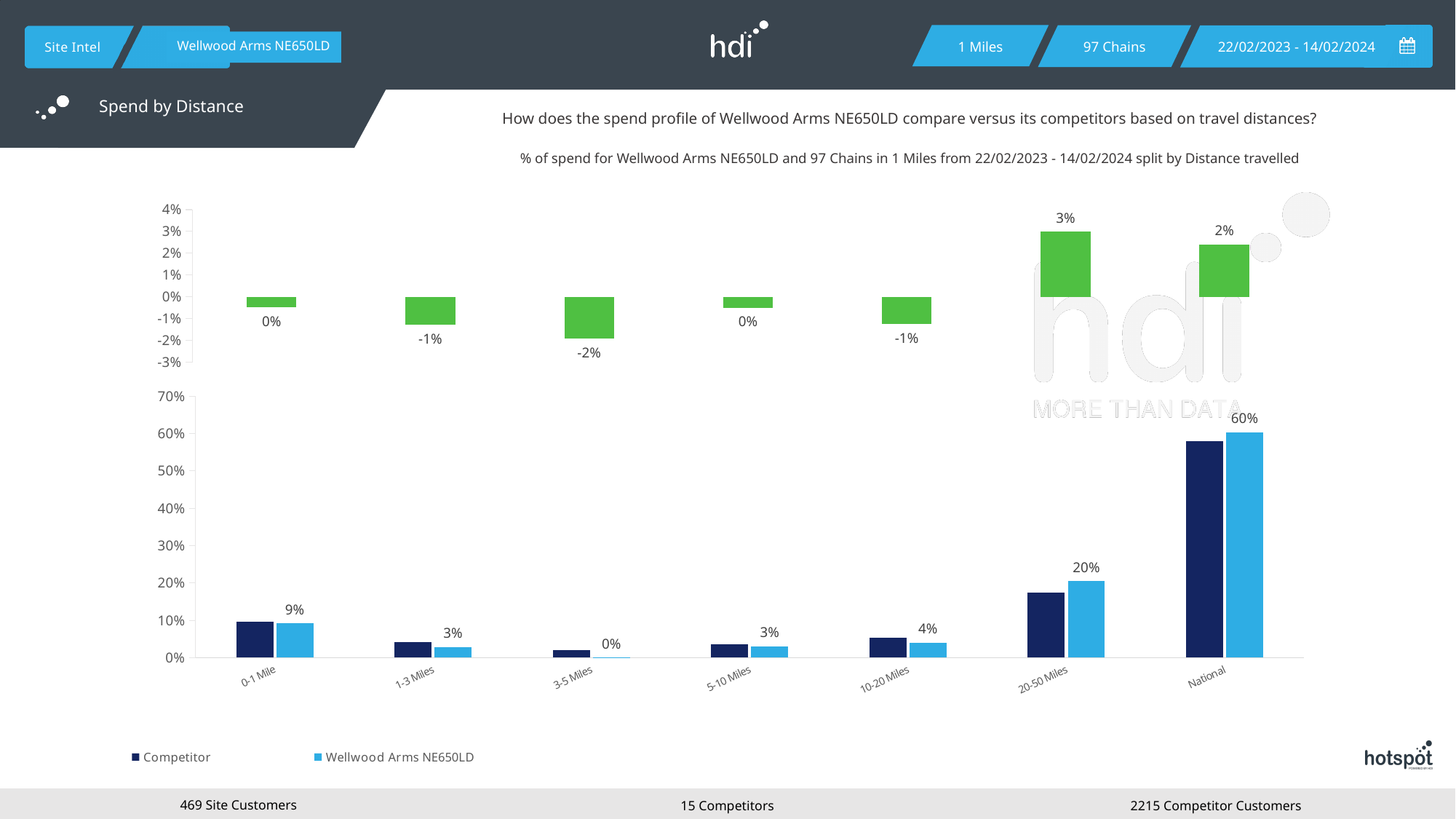
In the bottom chart, what is the difference between the Wellwood Arms NE650LD values for National and 20-50 Miles? 40% In the bottom chart, what is the value for Wellwood Arms NE650LD in the National category? 60% In the bottom chart, what is the value for Wellwood Arms NE650LD in the 20-50 Miles category? 20% In the bottom chart, is the Competitor value for National greater or less than 50%? greater In the bottom chart, what is the value for Wellwood Arms NE650LD in the 0-1 Mile category? 9% How many series does the legend of the bottom chart list? 2 How many categories are shown on the x axis of the bottom chart? 7 In the bottom chart, which category has the highest value for Wellwood Arms NE650LD? National